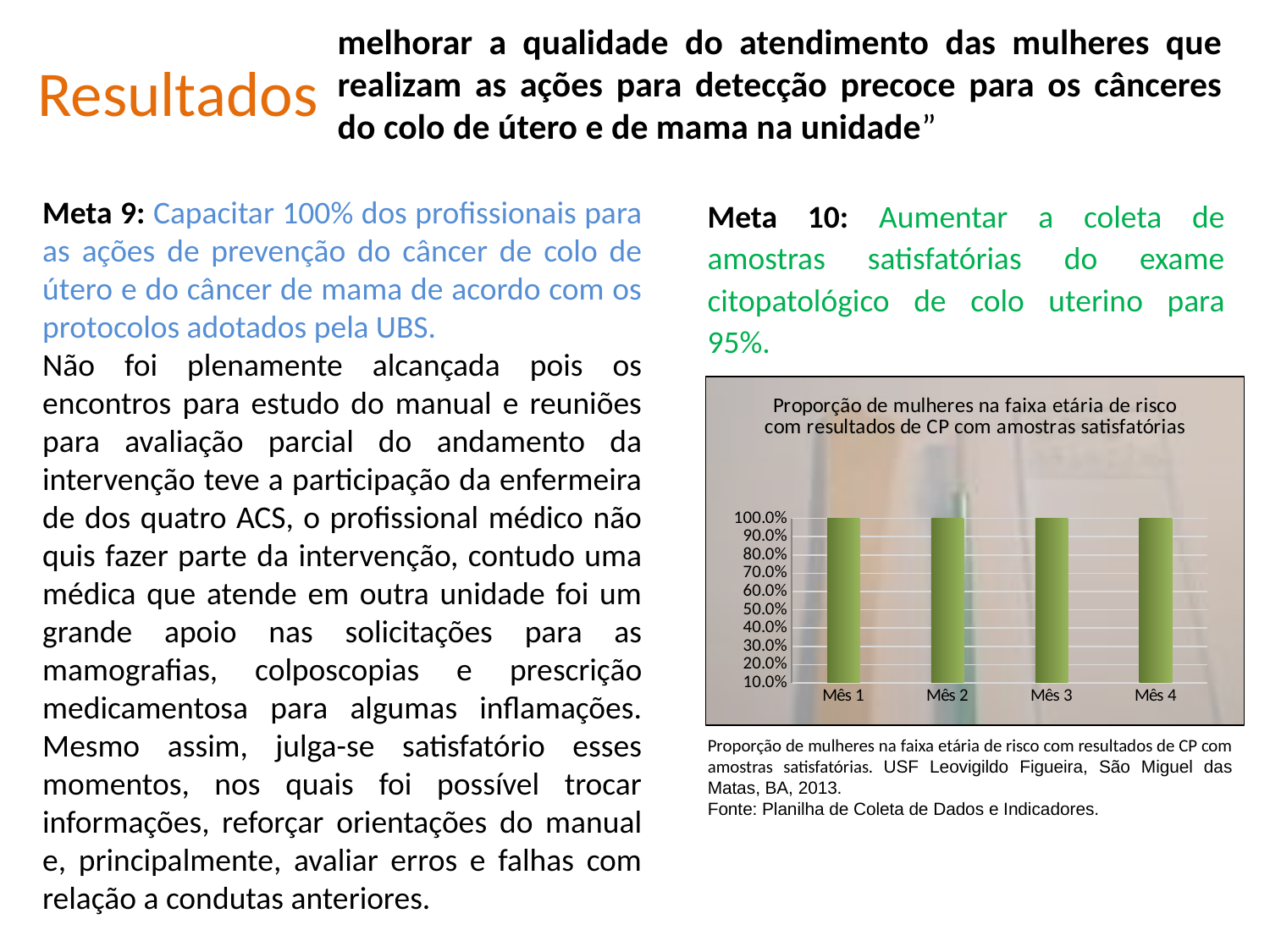
Is the value for Mês 2 greater or less than 50.0%? greater What is the title of the chart? Proporção de mulheres na faixa etária de risco com resultados de CP com amostras satisfatórias What is the label of the first category on the x axis? Mês 1 Do the values rise, fall, or stay the same from Mês 1 to Mês 4? stay the same What is the value for Mês 1 on the chart? 100.0% What is the value for Mês 4 on the chart? 100.0% What is the lowest tick value shown on the y axis? 10.0% Is the value for Mês 3 greater or less than 90.0%? greater What kind of chart is shown on the slide? bar chart How many categories (months) are plotted on the chart? 4